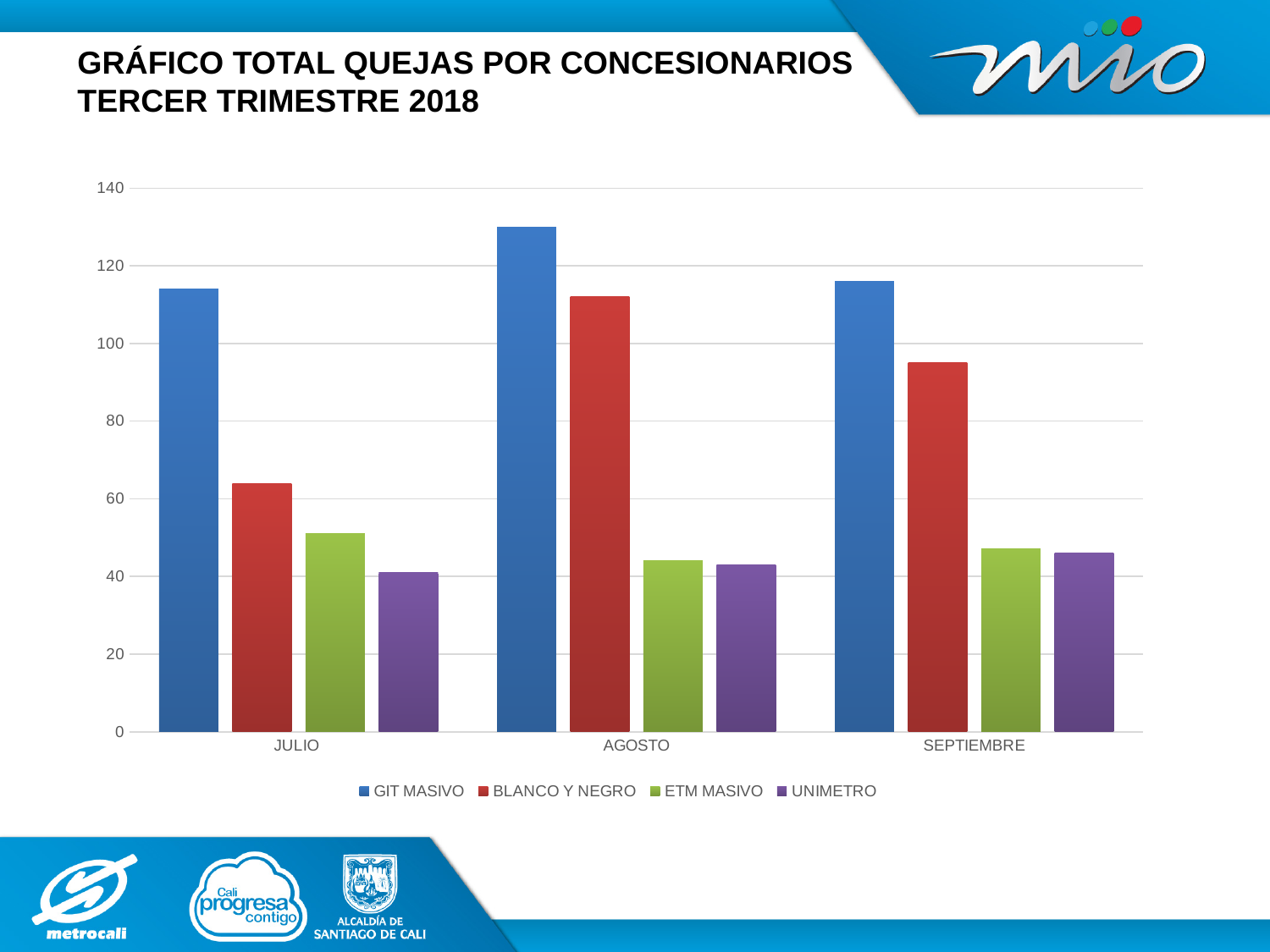
Does the value for BLANCO Y NEGRO rise or fall from JULIO to AGOSTO? rise Which is larger in JULIO, ETM MASIVO or UNIMETRO? ETM MASIVO How many months are shown on the x axis? 3 Is the value for BLANCO Y NEGRO in JULIO greater or less than 80? less Is the value for GIT MASIVO in AGOSTO greater or less than 120? greater In which month does GIT MASIVO reach its highest value? AGOSTO Is the value for BLANCO Y NEGRO in SEPTIEMBRE greater or less than 80? greater What kind of chart is shown on the slide? bar chart Which series has the highest value in AGOSTO? GIT MASIVO Which series has the lowest value in JULIO? UNIMETRO How many series does the legend list? 4 What colour are the bars for UNIMETRO? purple